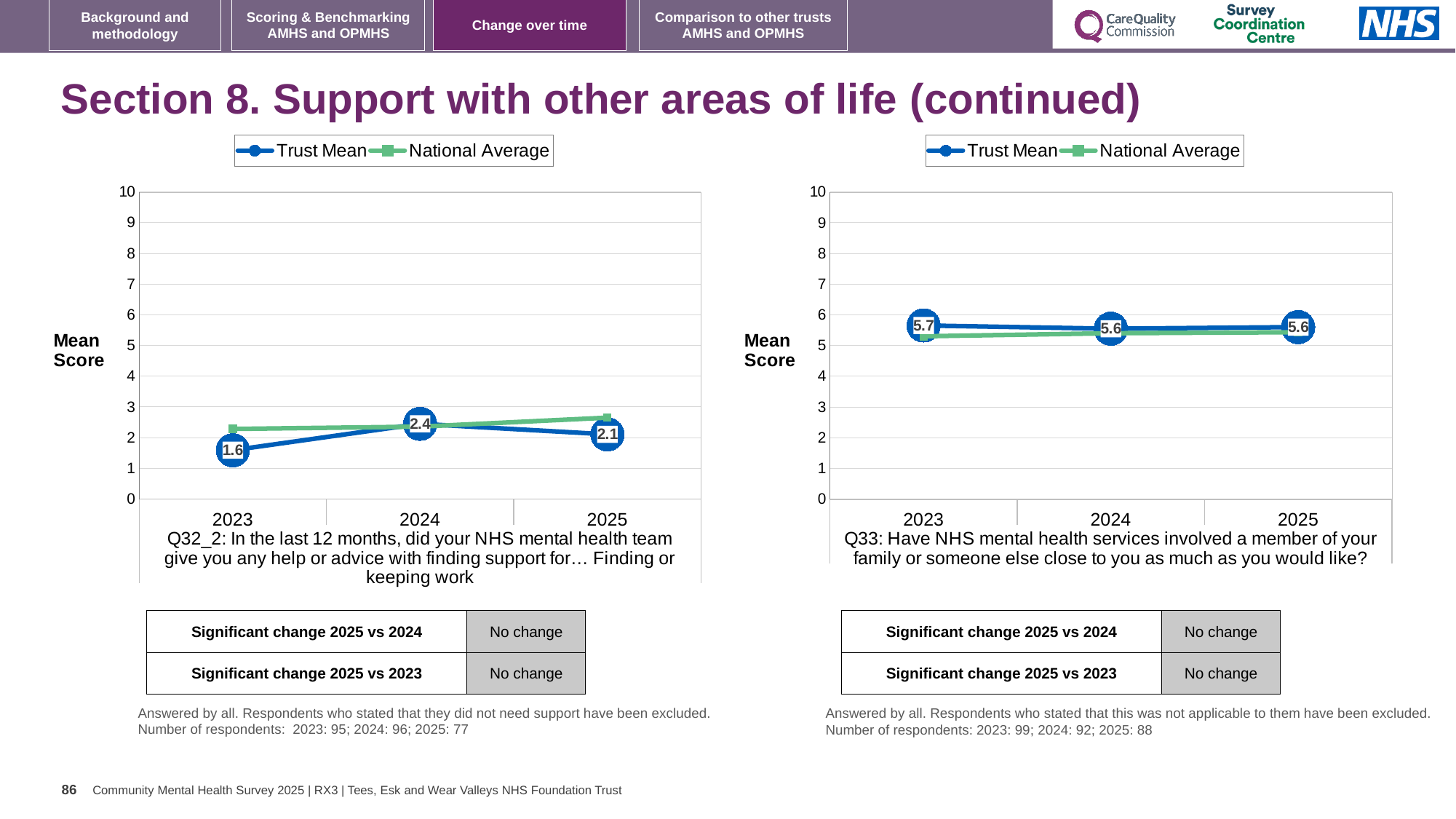
In the left chart (Q32_2), what is the difference between the Trust Mean for 2024 and 2023? 0.8 In the left chart (Q32_2), which year has the highest Trust Mean? 2024 In the right chart (Q33), in 2023, which is higher: the Trust Mean or the National Average? Trust Mean In the right chart (Q33), what is the difference between the Trust Mean for 2023 and 2025? 0.1 In the right chart (Q33), what is the Trust Mean for 2023? 5.7 In the left chart (Q32_2), what is the Trust Mean for 2023? 1.6 In the left chart (Q32_2), does the Trust Mean rise or fall from 2024 to 2025? fall In the left chart (Q32_2), which year has the lowest Trust Mean? 2023 In the left chart (Q32_2), what is the Trust Mean for 2024? 2.4 What kind of chart is the right chart (Q33)? line chart In the right chart (Q33), how many series does the legend list? 2 In the left chart (Q32_2), is the National Average for 2025 greater or less than 3? less